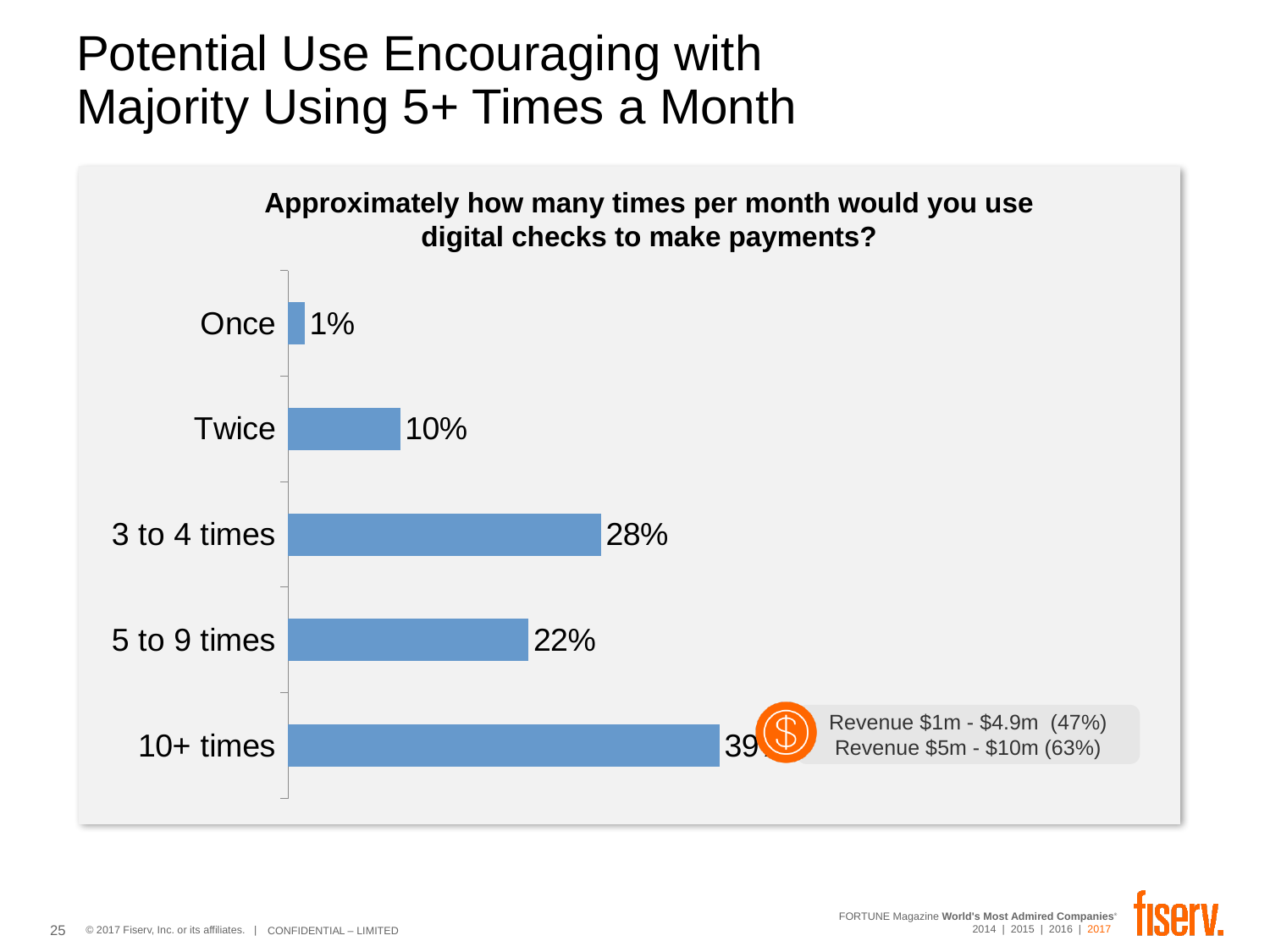
What is the value shown for 'Twice'? 10% What is the difference between the values for '3 to 4 times' and '5 to 9 times'? 6% What is the value for '5 to 9 times'? 22% Which category has the smallest value? Once What percentage is shown for '3 to 4 times'? 28% Which category has the longest bar in the chart? 10+ times Which is larger, the value for 'Twice' or the value for '5 to 9 times'? 5 to 9 times How many categories are shown in the chart? 5 What is the difference between the values for 'Twice' and 'Once'? 9% What type of chart is shown on the slide? Bar chart What is the title of the chart? Approximately how many times per month would you use digital checks to make payments? What percentage of respondents said they would use digital checks once per month? 1%